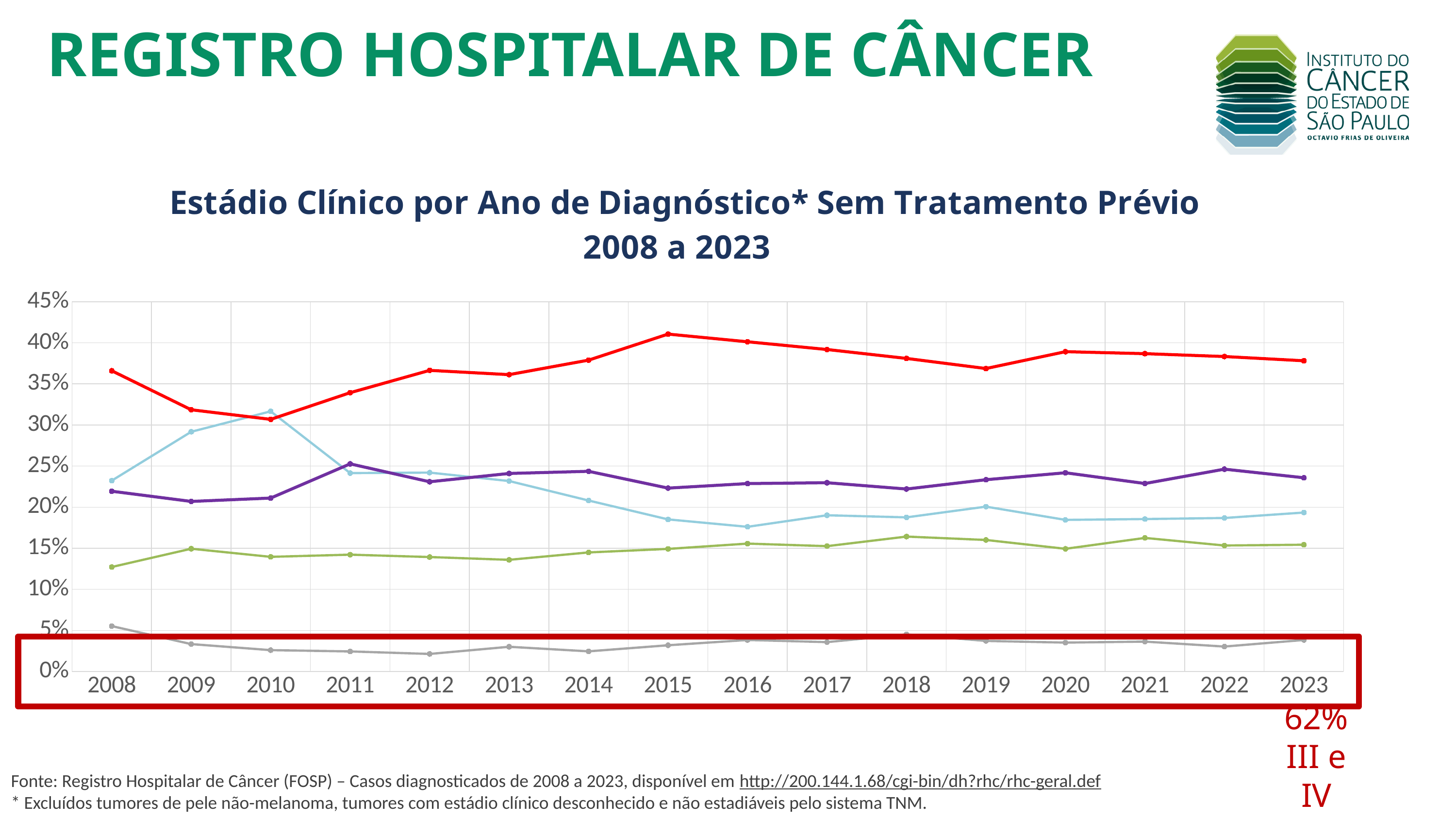
In which year does the red line reach its lowest value? 2010 In which year does the red line reach its highest value? 2015 How many lines (data series) are plotted on the chart? 5 In which year does the light blue line reach its highest value? 2010 Is the value of the red line in 2010 greater or less than 35%? less What is the title of the chart? Estádio Clínico por Ano de Diagnóstico* Sem Tratamento Prévio 2008 a 2023 In 2008, which line has the larger value, the red line or the light blue line? red line Is the value of the light blue line in 2010 greater or less than 25%? greater Does the light blue line rise or fall between 2010 and 2016? fall What kind of chart is shown on the slide? line chart Is the value of the gray line in 2008 greater or less than 10%? less How many years are shown on the x axis of the chart? 16